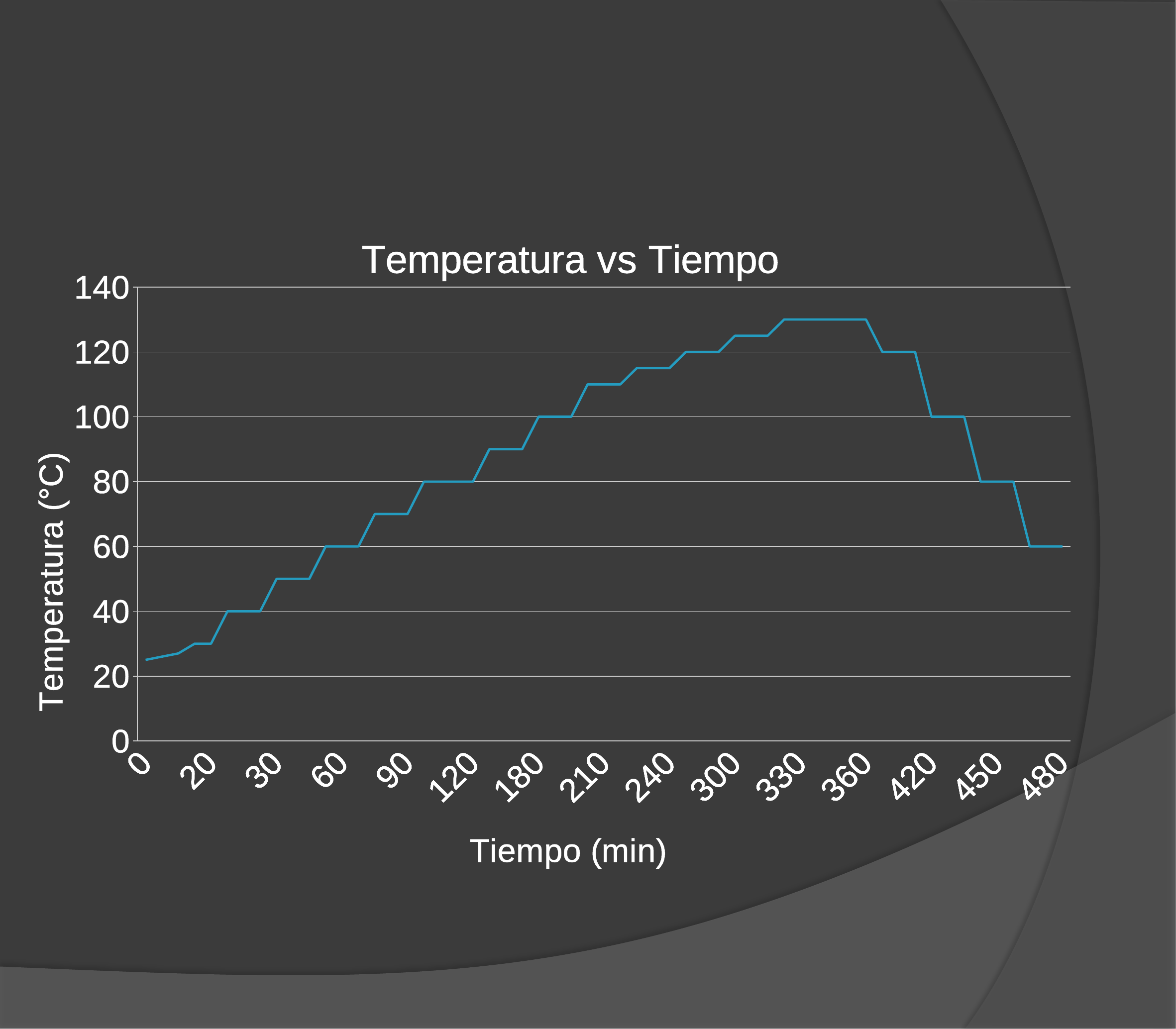
Is the highest temperature reached on the chart greater or less than 140? less How many labels are shown on the horizontal (Tiempo) axis? 15 What kind of chart is shown on the slide? line chart Which is larger, the temperature at time 0 or the temperature at 480 min? 480 min Is the temperature at time 0 greater or less than 40? less What is the temperature value at the final time label, 480 min? 60 Is the temperature at 480 min greater or less than 80? less What is the label of the vertical axis? Temperatura (°C) How does the temperature change along the time axis overall? rises, then falls What is the title of the chart? Temperatura vs Tiempo What is the highest value shown on the vertical axis? 140